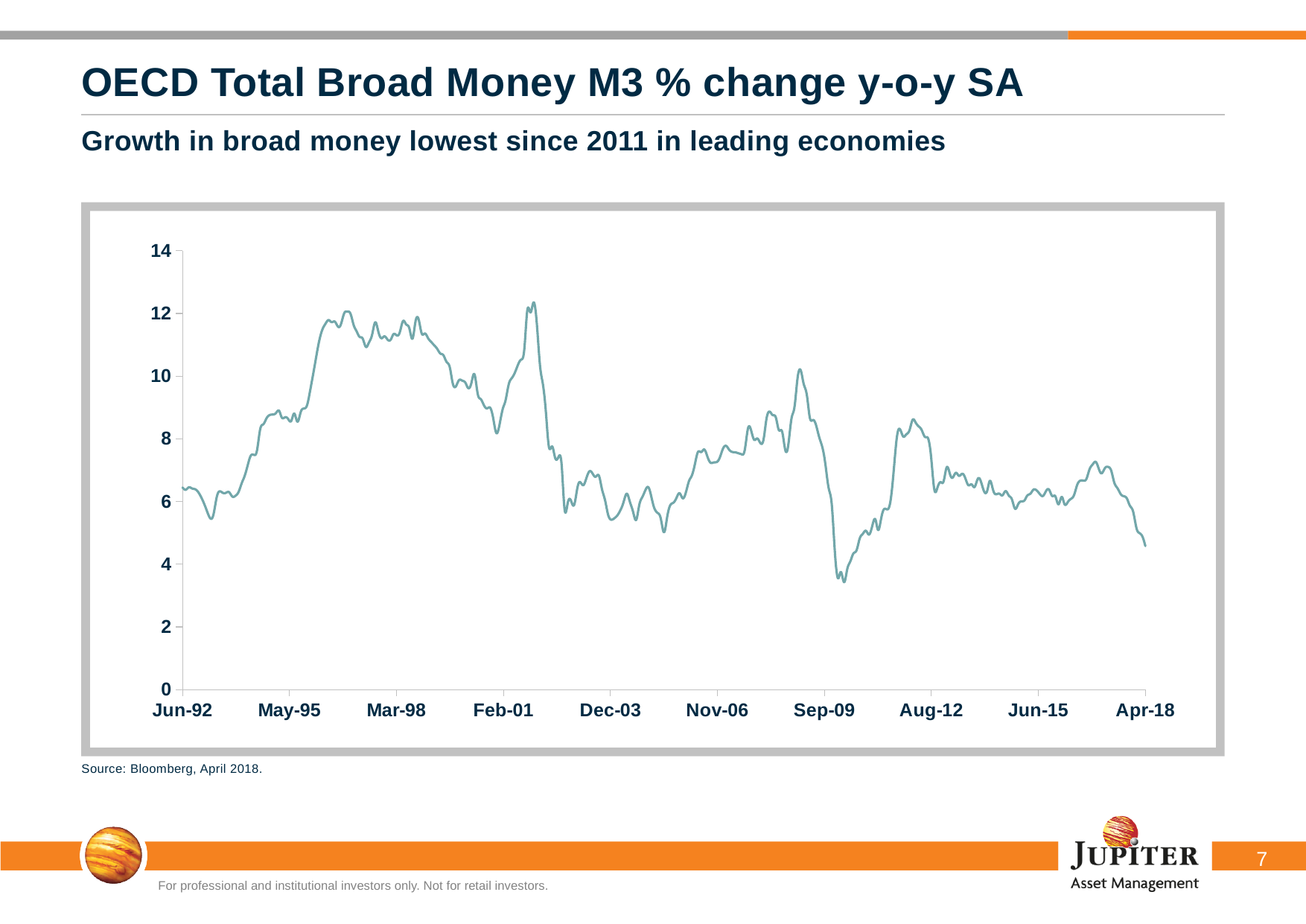
What kind of chart is shown on the slide? line chart Is the value at Jun-92 greater or less than 8? less What source is cited for the chart? Bloomberg, April 2018. What is the title of the chart on the slide? OECD Total Broad Money M3 % change y-o-y SA Does the line rise or fall between Jun-92 and May-95? rise Does the line rise or fall between Jun-15 and Apr-18? fall Is the value at Apr-18 greater or less than 6? less Is the highest point of the line greater or less than 10? greater How many date labels are shown on the x axis? 10